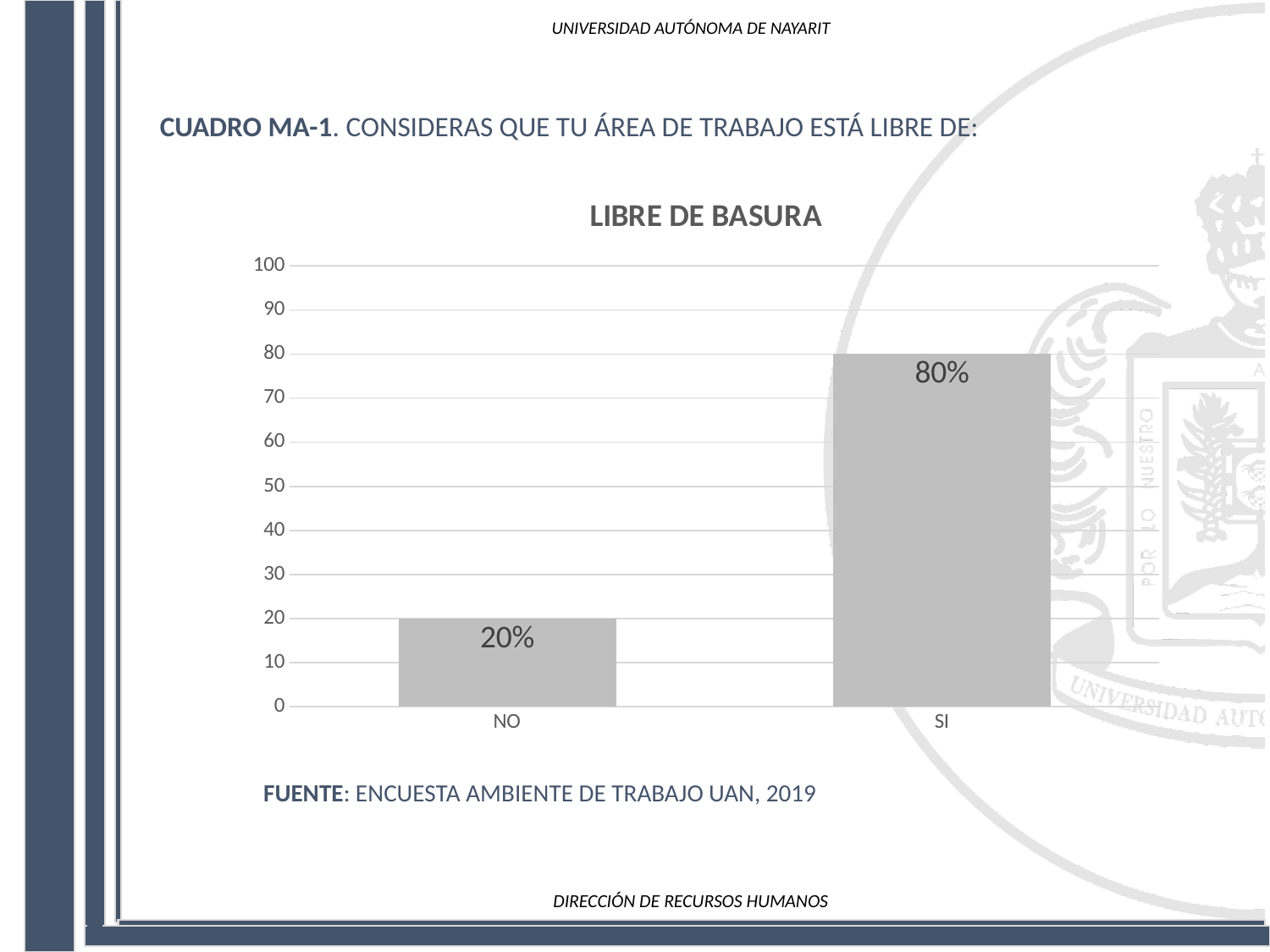
Is the value for SI greater or less than 50? greater Which category has the lowest value? NO How many categories are shown on the x axis? 2 Which is larger, the value for NO or the value for SI? SI What is the value for SI? 80% What is the maximum value shown on the vertical axis? 100 What is the title of the chart? LIBRE DE BASURA What is the difference between the values for SI and NO? 60% What kind of chart is shown? bar chart Is the value for NO greater or less than 30? less What is the value for NO? 20% Which category has the highest value? SI